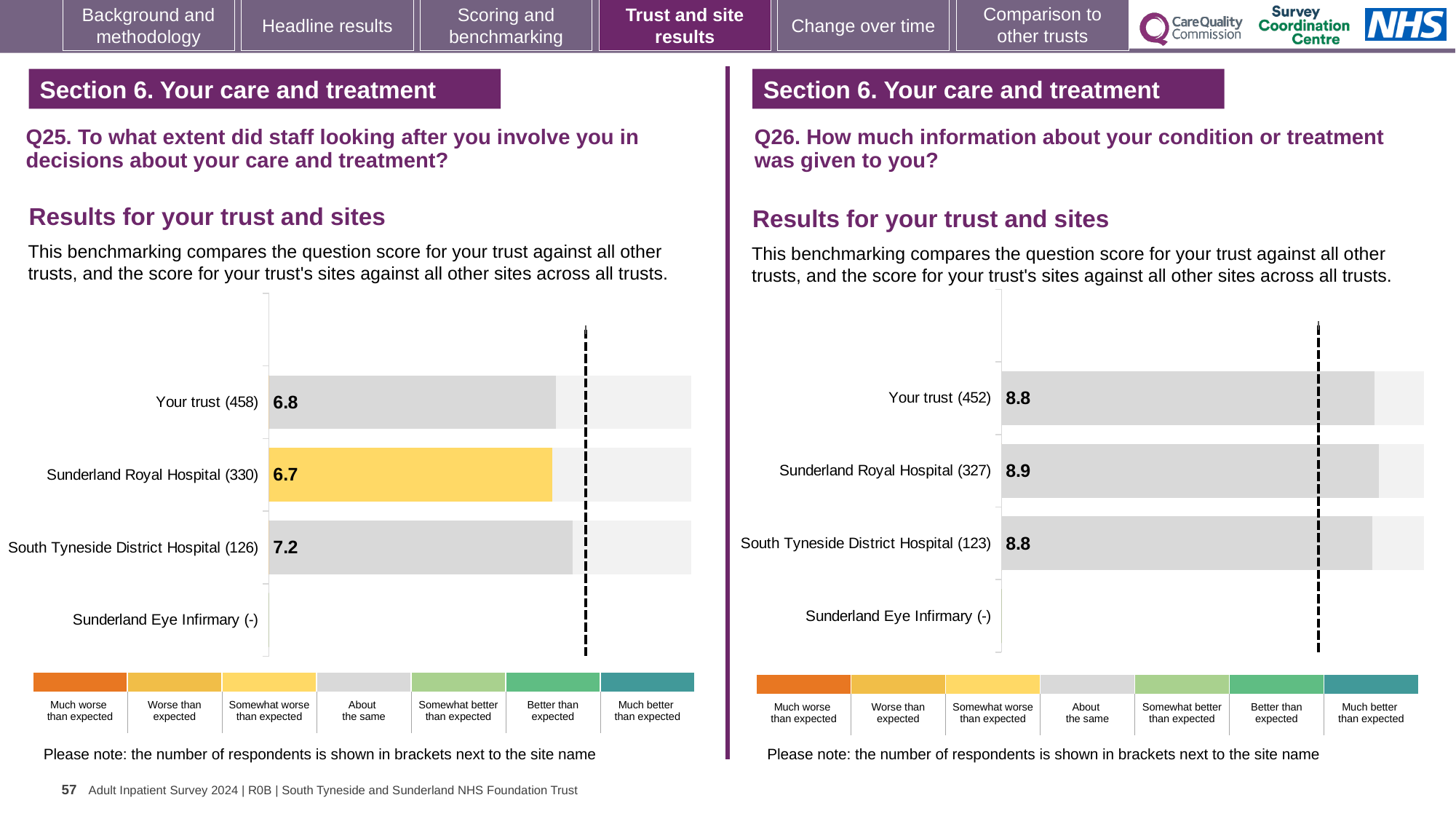
On the Q26 chart, what is the score for Sunderland Royal Hospital? 8.9 On the Q25 chart, which site has the highest score? South Tyneside District Hospital On the Q25 chart, what is the score for Your trust? 6.8 On the Q25 chart, what is the difference between the scores for South Tyneside District Hospital and Sunderland Royal Hospital? 0.5 On the Q25 chart, which benchmark category does the colour of the Sunderland Royal Hospital bar correspond to? Somewhat worse than expected On the Q26 chart, what is the difference between the scores for Sunderland Royal Hospital and Your trust? 0.1 What kind of chart is used on the Q25 side of the slide? Bar chart How many respondents are shown in brackets for Your trust on the Q26 chart? 452 On the Q26 chart, what is the score for South Tyneside District Hospital? 8.8 On the Q25 chart, which site has the lowest score? Sunderland Royal Hospital On the Q26 chart, which is larger, the score for Sunderland Royal Hospital or the score for Your trust? Sunderland Royal Hospital On the Q25 chart, what is the score for South Tyneside District Hospital? 7.2